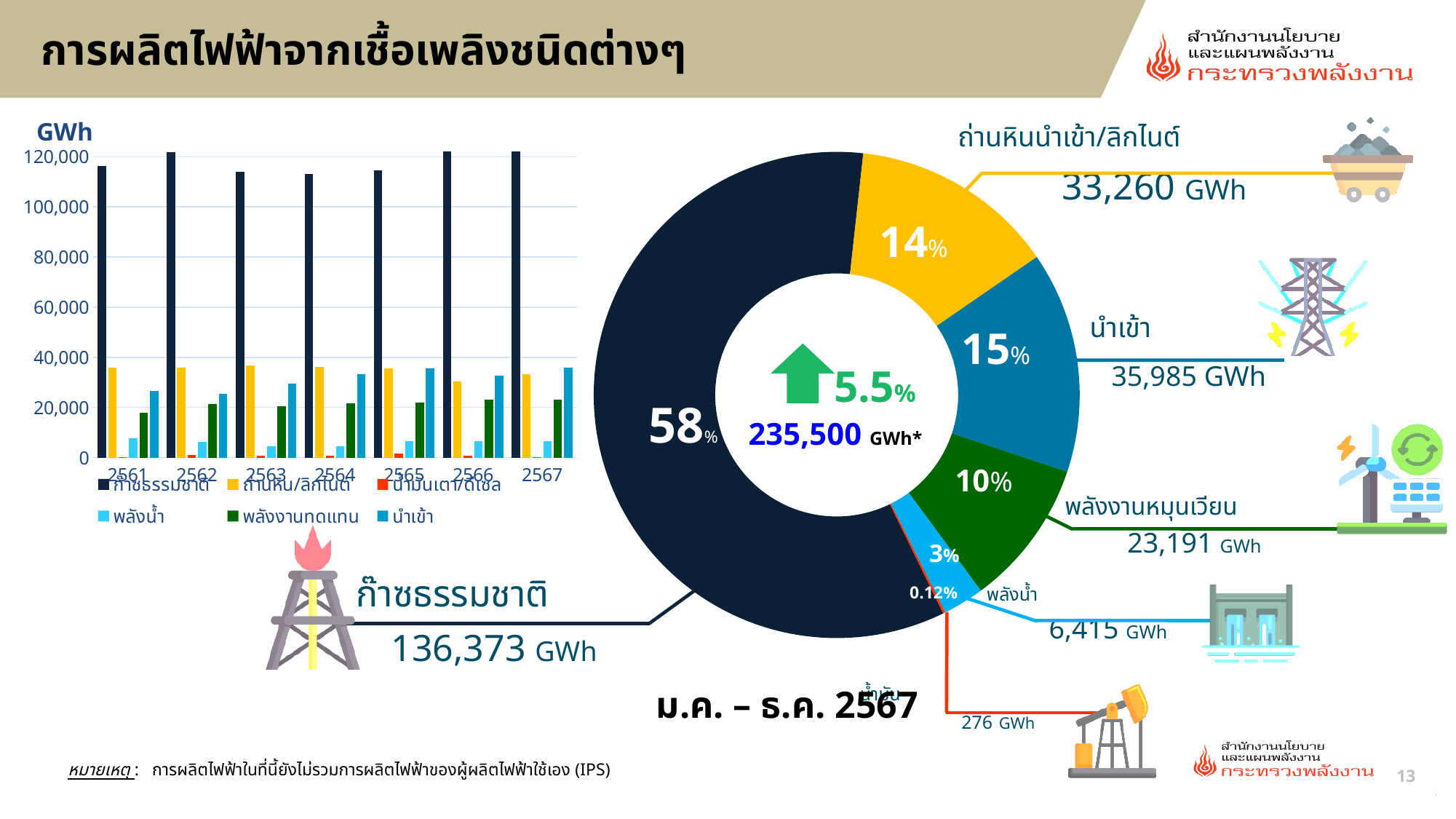
In the donut chart, which is larger: พลังงานหมุนเวียน or พลังน้ำ? พลังงานหมุนเวียน In the donut chart, what is the difference in GWh between นำเข้า (35,985 GWh) and ถ่านหินนำเข้า/ลิกไนต์ (33,260 GWh)? 2,725 GWh What total GWh value is shown in the centre of the donut chart? 235,500 GWh* In the donut chart, which fuel source has the largest share? ก๊าซธรรมชาติ In the bar chart on the left, is the value for ถ่านหิน/ลิกไนต์ in 2561 greater or less than 40,000? less What kind of chart is the chart on the left of the slide? bar chart In the bar chart on the left, is the value for ก๊าซธรรมชาติ in 2562 greater or less than 100,000? greater How many years are shown on the x axis of the bar chart on the left? 7 In the donut chart, what is the smallest percentage shown on any slice? 0.12% In the donut chart, what share of electricity generation comes from ก๊าซธรรมชาติ? 58% In the donut chart, how many GWh were generated from นำเข้า? 35,985 GWh How many series does the legend of the bar chart on the left list? 6